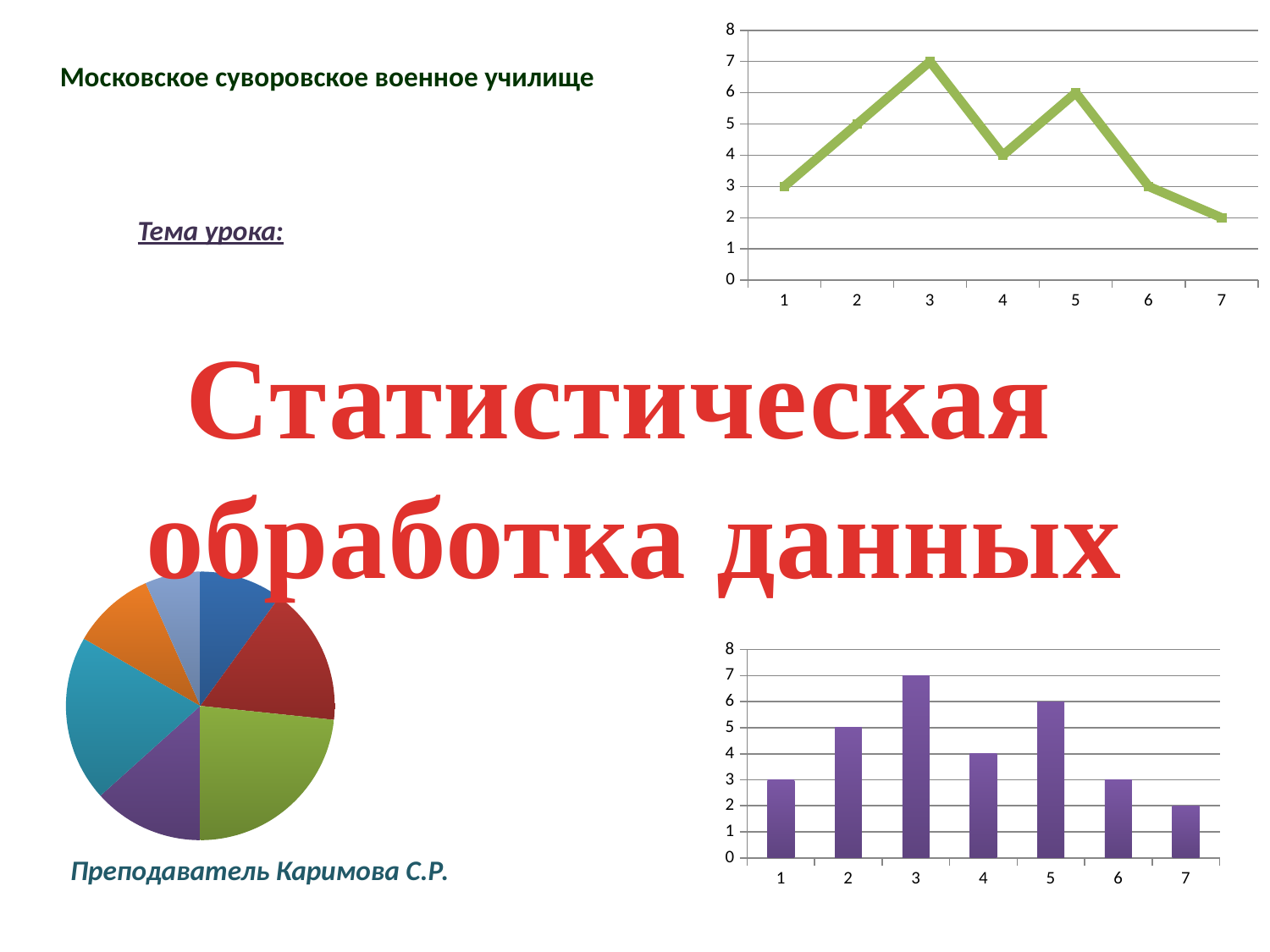
In the line chart at the top right, which point has the lowest value? 7 What kind of chart is shown in the bottom right of the slide? bar chart What kind of chart is shown in the top right of the slide? line chart In the bar chart at the bottom right, what is the value for category 7? 2 In the line chart at the top right, what is the value at point 5? 6 How many slices does the pie chart at the bottom left have? 7 In the line chart at the top right, which is larger, the value at point 2 or the value at point 6? point 2 In the bar chart at the bottom right, what is the value for category 3? 7 What kind of chart is shown in the bottom left of the slide? pie chart In the bar chart at the bottom right, which category has the highest value? 3 In the bar chart at the bottom right, what is the difference between the values for category 3 and category 4? 3 How many categories are shown on the x axis of the bar chart at the bottom right? 7